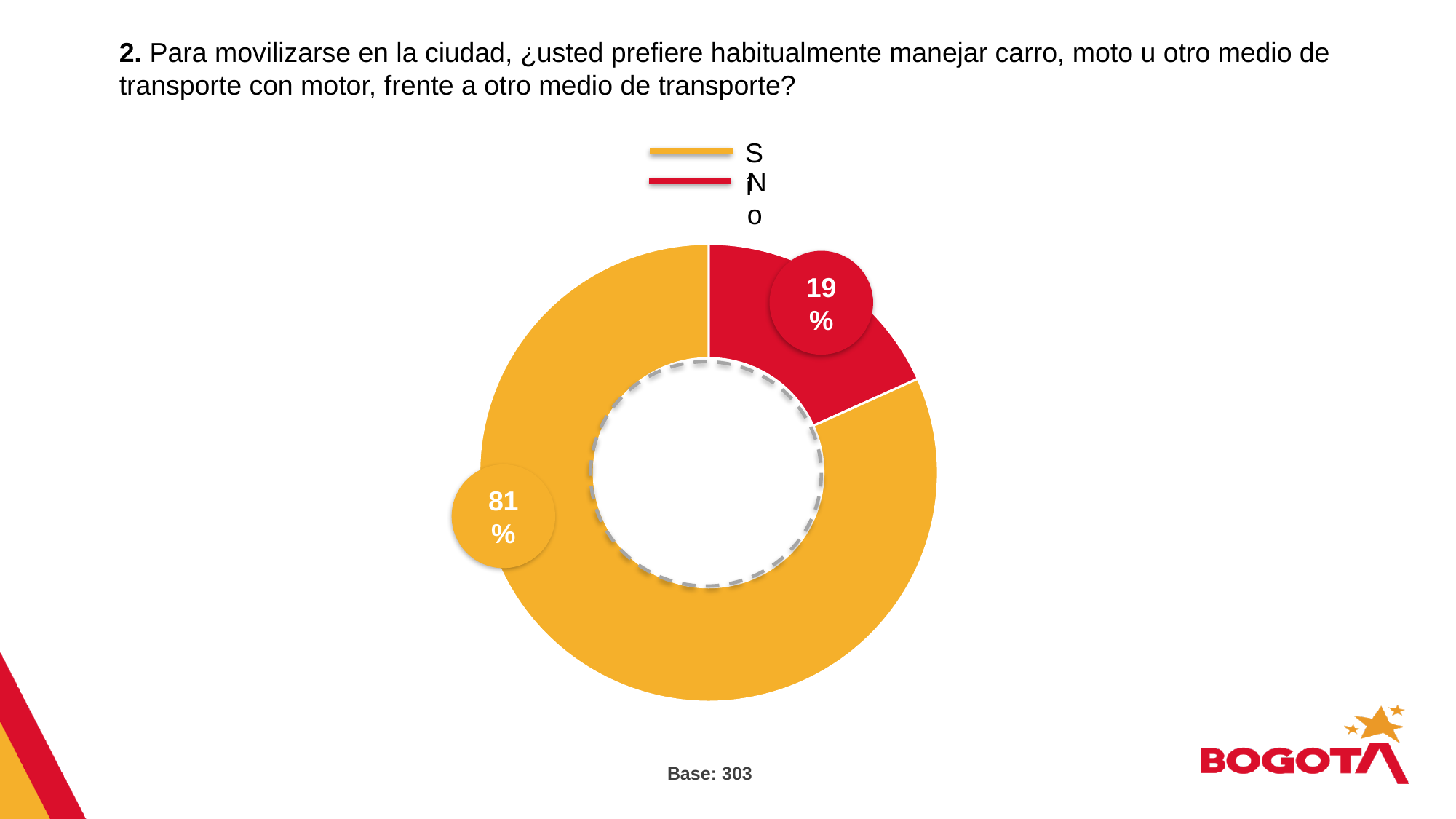
What percentage of respondents answered "Sí"? 81% Which is larger, the share for "Sí" or the share for "No"? Sí What is the difference in percentage points between the "Sí" and "No" shares? 62 Which response has the largest share of the chart? Sí What is the base (number of respondents) shown below the chart? 303 What colour is the slice for "No"? Red What kind of chart is shown on the slide? Donut (pie) chart How many slices does the chart have? 2 How many entries does the legend list? 2 What percentage of respondents answered "No"? 19% Which response has the smallest share of the chart? No